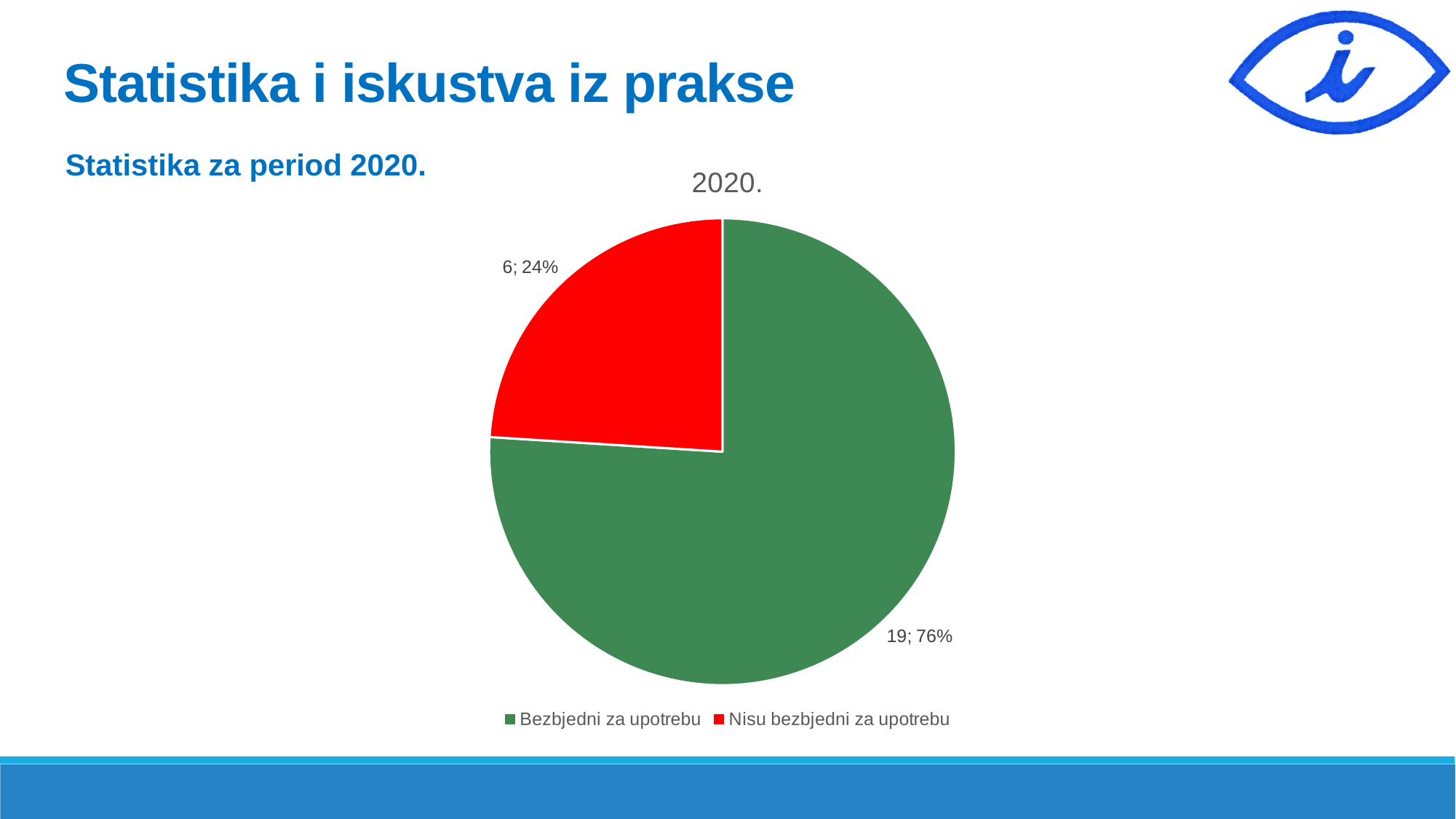
Which colour represents Nisu bezbjedni za upotrebu? red What share of the pie does Bezbjedni za upotrebu represent? 76% Which category has the smallest slice? Nisu bezbjedni za upotrebu How many slices does the pie chart have? 2 What kind of chart is shown on the slide? pie chart What share of the pie does Nisu bezbjedni za upotrebu represent? 24% What is the value for Bezbjedni za upotrebu? 19 What is the difference between the values for Bezbjedni za upotrebu and Nisu bezbjedni za upotrebu? 13 How many entries does the legend list? 2 Which category has the largest slice? Bezbjedni za upotrebu What is the value for Nisu bezbjedni za upotrebu? 6 What is the title of the chart? 2020.